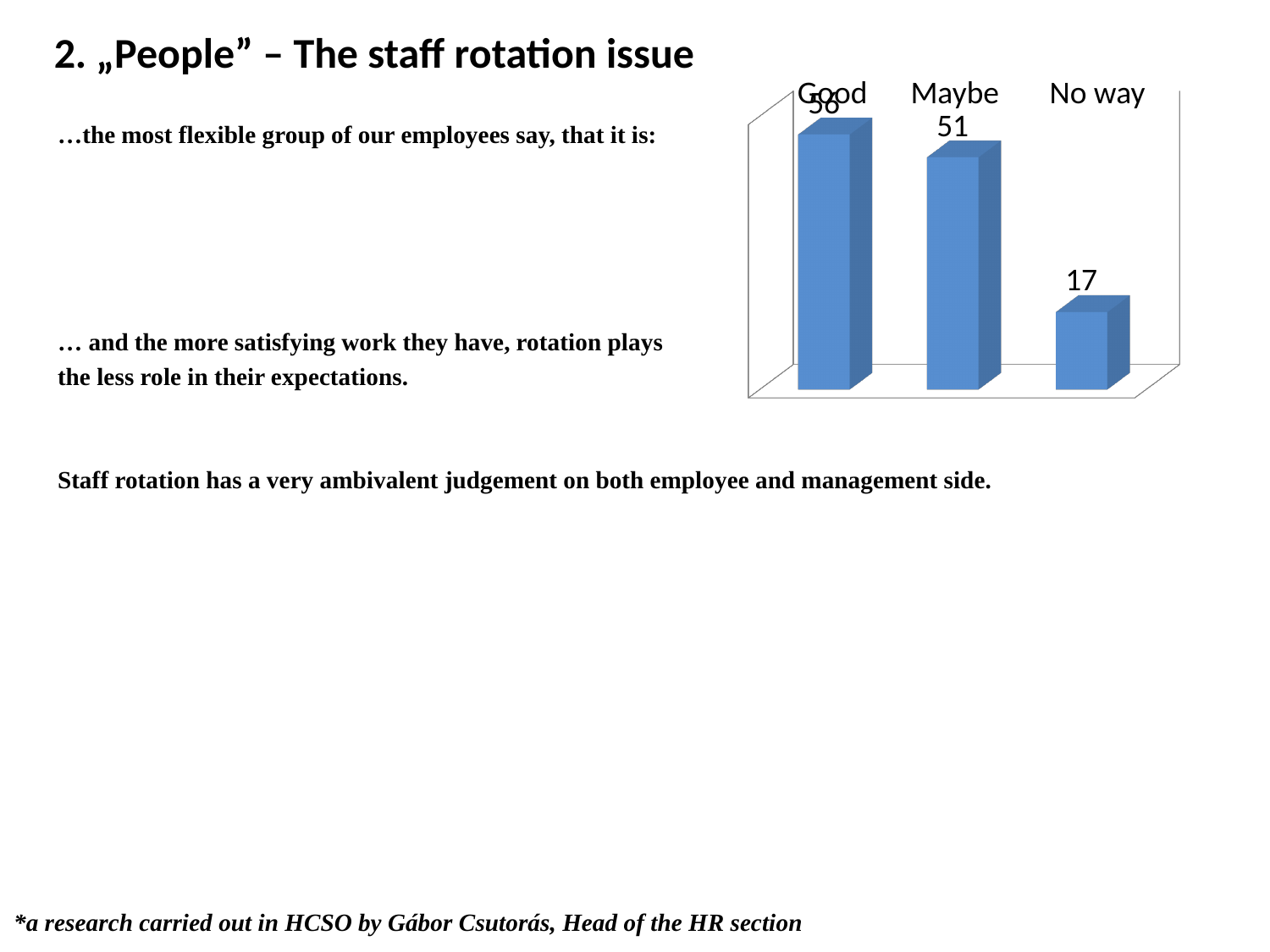
What colour are the bars in the chart? Blue What is the value for No way? 17 What are the three category labels shown in the chart? Good, Maybe, No way Which category has the highest value? Good How many categories are shown in the chart? 3 Which is larger, the value for Good or the value for Maybe? Good What is the value for Maybe? 51 What kind of chart is shown on the slide? Bar chart Do the values rise or fall from Good to No way along the x axis? Fall Which is larger, the value for Maybe or the value for No way? Maybe What is the difference between the values for Maybe and No way? 34 Which category has the lowest value? No way